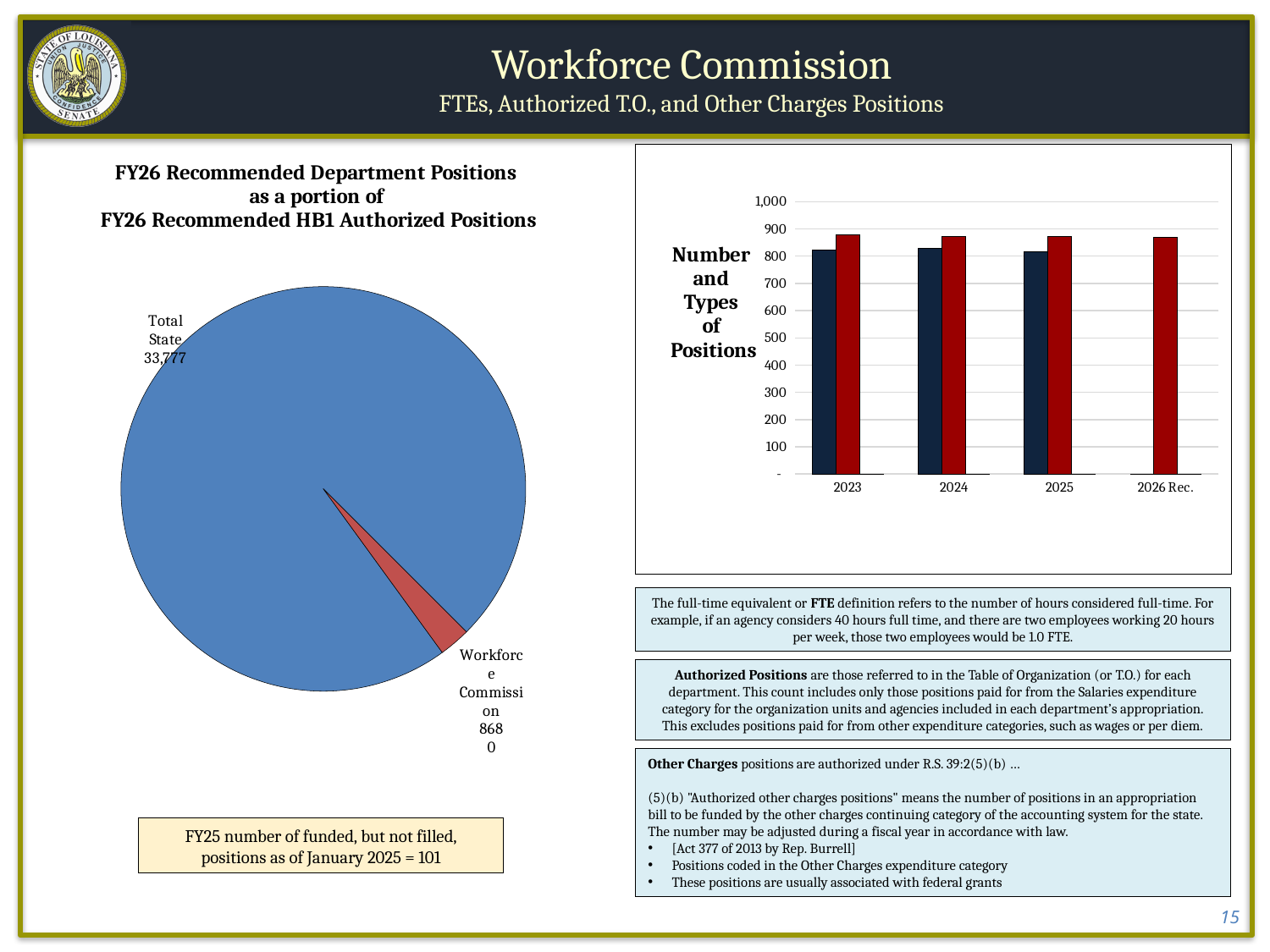
In the 'Number and Types of Positions' chart, what is the highest value labelled on the vertical axis? 1,000 In the 'Number and Types of Positions' chart, which year category has no dark navy bar? 2026 Rec. In the 'Number and Types of Positions' chart, is the red bar for 2023 greater or less than 800? greater In the 'Number and Types of Positions' chart, is the dark navy bar for 2023 greater or less than 900? less In the pie chart on the left, which slice is larger, Total State or Workforce Commission? Total State What kind of chart is the one on the left titled 'FY26 Recommended Department Positions as a portion of FY26 Recommended HB1 Authorized Positions'? Pie chart In the pie chart on the left, what value is shown for Total State? 33,777 In the 'Number and Types of Positions' chart, is the dark navy bar for 2025 greater or less than 700? greater What kind of chart is the 'Number and Types of Positions' chart on the right? Bar chart In the 'Number and Types of Positions' chart, how many year categories are shown on the x axis? 4 In the pie chart on the left, what value is shown for Workforce Commission? 868